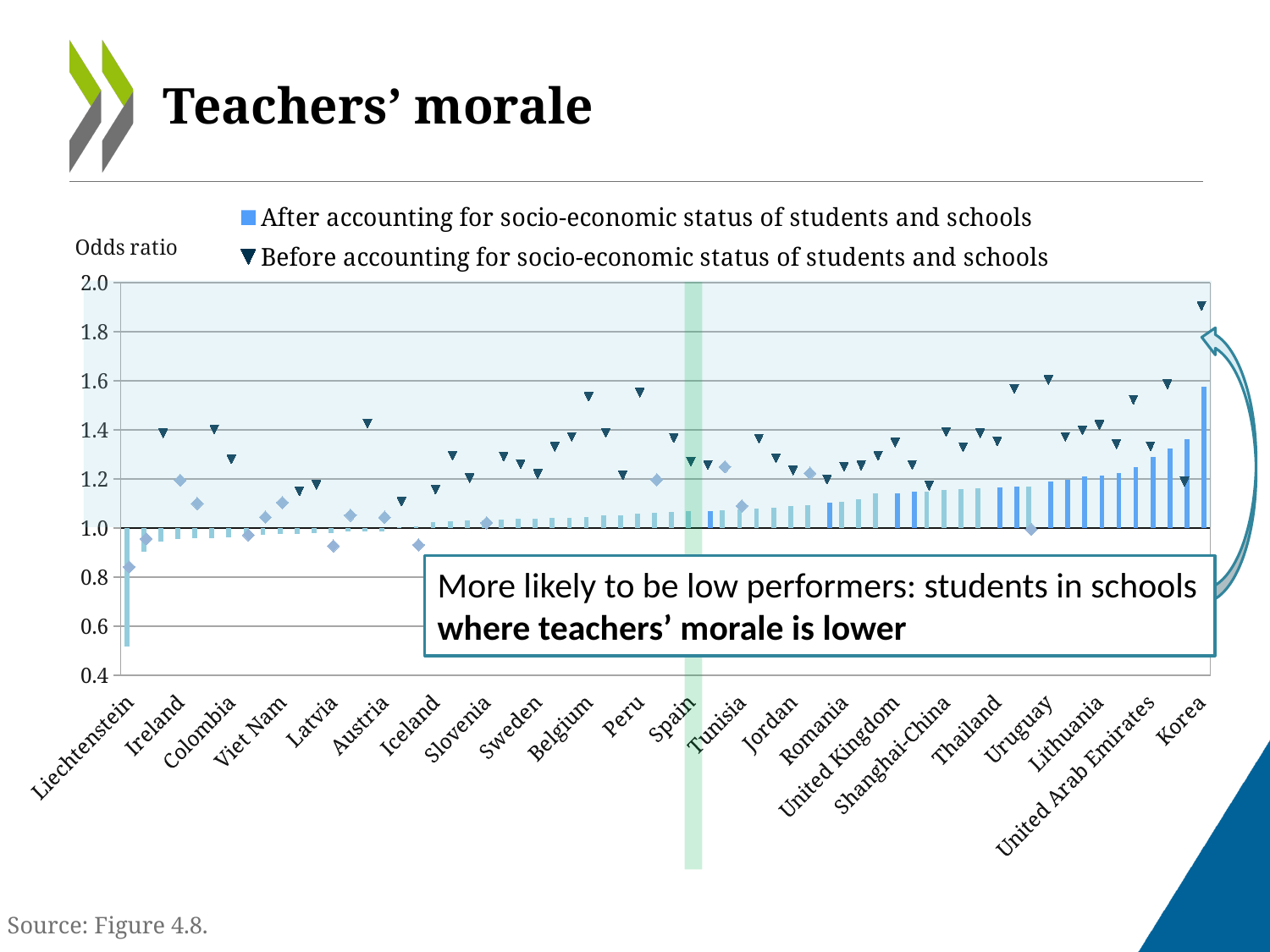
Is the odds ratio for Liechtenstein after accounting for socio-economic status greater or less than 0.8? less Is the odds ratio for Korea after accounting for socio-economic status greater or less than 1.4? greater What kind of chart is shown on the slide? Bar chart Which country has the lowest odds ratio after accounting for socio-economic status of students and schools? Liechtenstein How many series does the legend list? 2 Is the odds ratio for Spain before accounting for socio-economic status greater or less than 1.4? less Which country has the highest odds ratio after accounting for socio-economic status of students and schools? Korea Which is larger: the odds ratio after accounting for socio-economic status for Korea or for Liechtenstein? Korea What is the label on the vertical axis of the chart? Odds ratio Do the bars for the odds ratio after accounting for socio-economic status rise or fall from left to right along the x axis? Rise Which country has the highest odds ratio before accounting for socio-economic status of students and schools? Korea